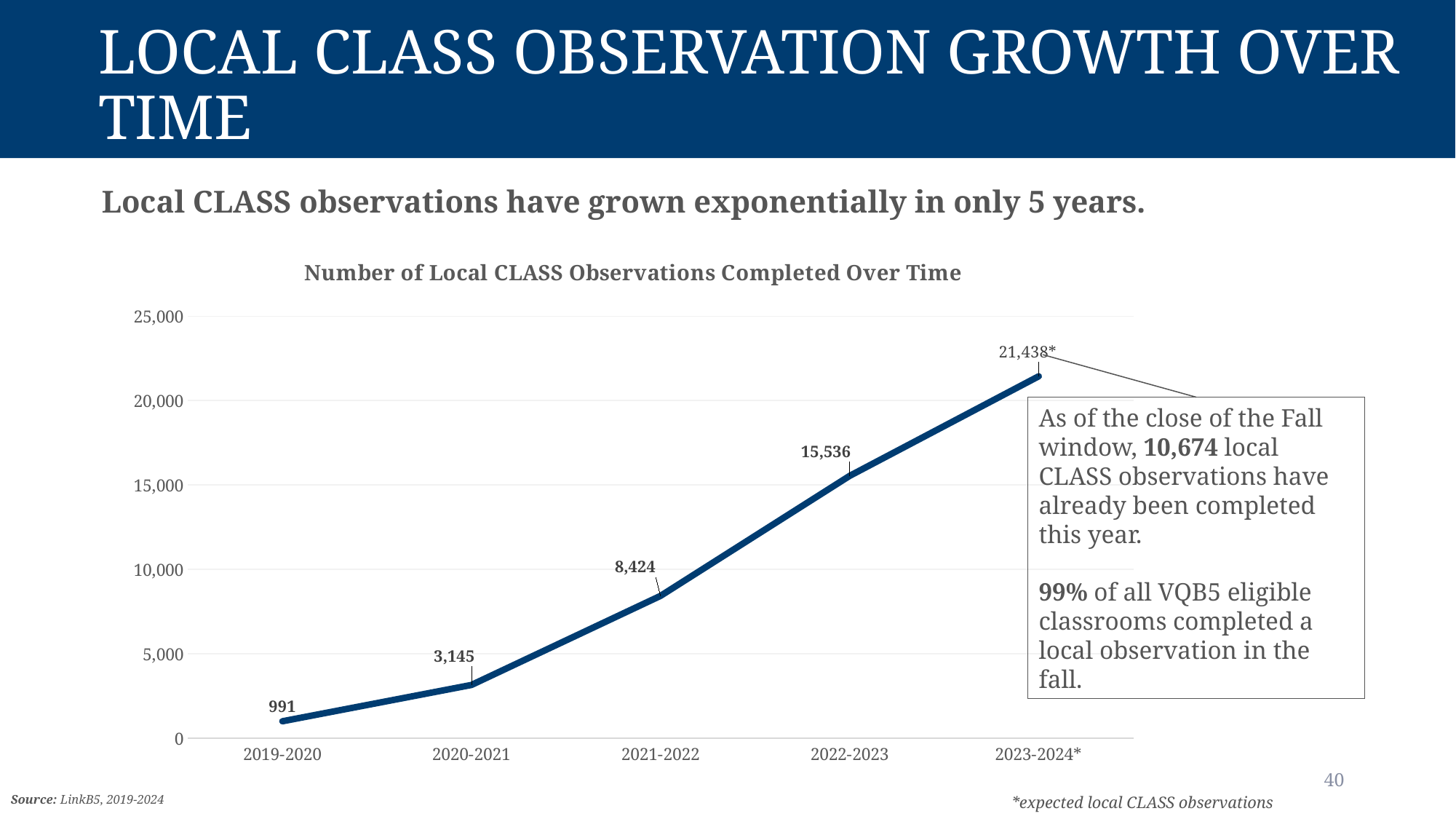
How many school years are plotted on the chart? 5 What is the number of local CLASS observations completed in 2019-2020? 991 Is the value for 2022-2023 greater or less than 15,000? greater What is the number of local CLASS observations completed in 2022-2023? 15,536 What is the number of local CLASS observations completed in 2021-2022? 8,424 Which year has the lowest number of local CLASS observations? 2019-2020 What is the difference between the 2022-2023 and 2021-2022 values? 7,112 What kind of chart is shown on the slide? line chart Which is larger, the value for 2020-2021 or the value for 2021-2022? 2021-2022 What is the expected number of local CLASS observations for 2023-2024? 21,438 Do the values rise or fall from 2019-2020 to 2023-2024? rise Which year has the highest number of local CLASS observations? 2023-2024*